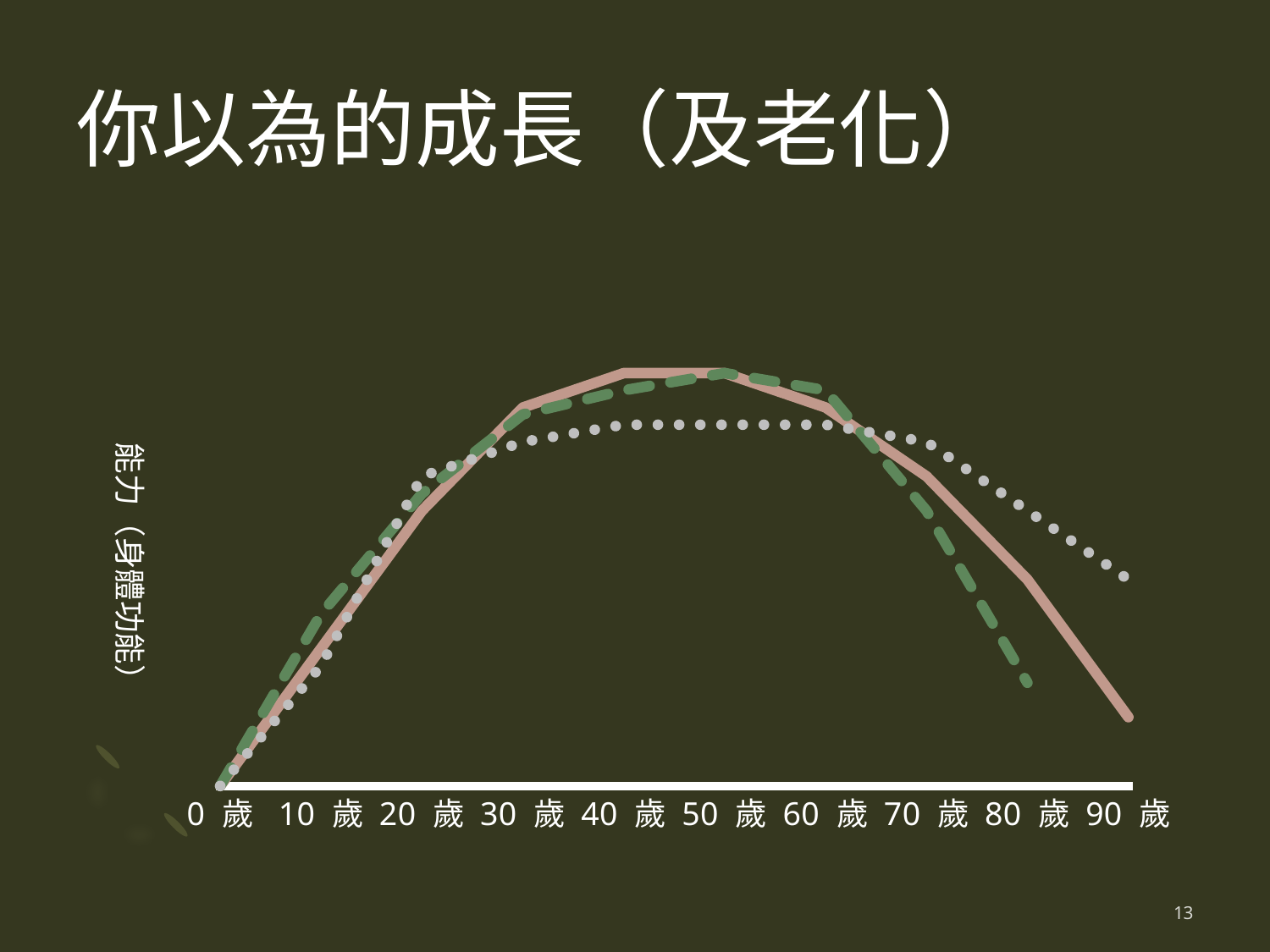
What is the title of the slide containing the chart? 你以為的成長（及老化） What is the last age label on the x axis? 90 歲 Do the lines rise or fall between 0 歲 and 40 歲? rise At 80 歲, which line is the lowest? the dashed green line What kind of chart is shown on the slide? line chart Which of the three lines reaches the lowest peak? the dotted grey line What is the first age label on the x axis? 0 歲 At 90 歲, which line is higher: the solid pink line or the dotted grey line? the dotted grey line How many age labels are shown along the x axis? 10 How many lines are plotted on the chart? 3 What is the label on the vertical axis of the chart? 能力（身體功能） Do the lines rise or fall between 60 歲 and 90 歲? fall